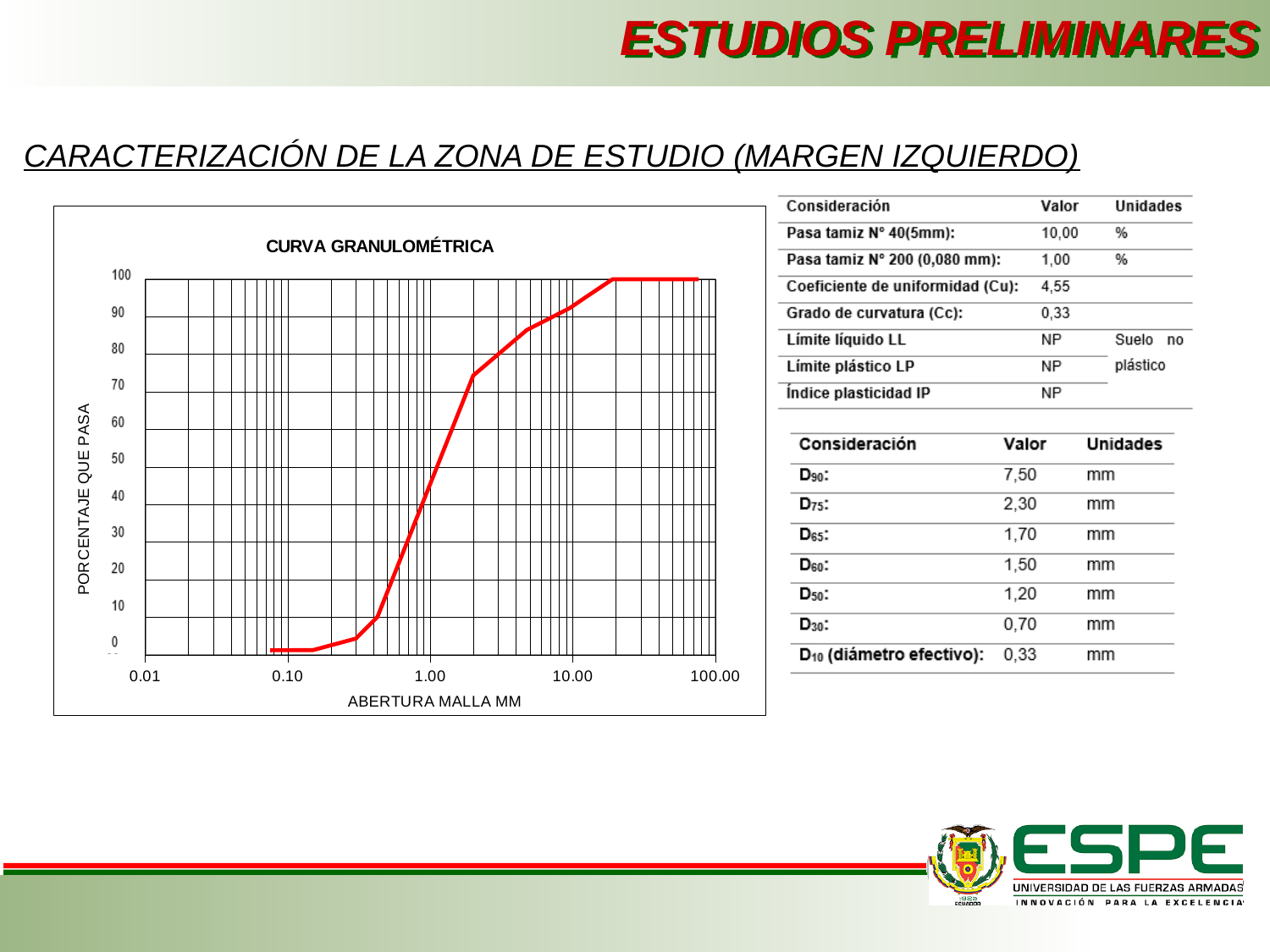
Is the value of the curve at 0.10 mm greater or less than 10? less Which is larger, the value of the curve at 1.00 mm or at 10.00 mm? 10.00 mm Is the value of the curve at 1.00 mm greater or less than 20? greater What kind of chart is shown on the slide? line chart What is the title of the chart? CURVA GRANULOMÉTRICA Is the value of the curve at 10.00 mm greater or less than 80? greater Does the curve rise or fall as the mesh opening (ABERTURA MALLA MM) increases along the x axis? rise How many labelled tick marks are shown on the x axis of the chart? 5 What is the largest value labelled on the x axis of the chart? 100.00 What is the label of the y axis of the chart? PORCENTAJE QUE PASA What is the highest value the curve reaches on the y axis? 100